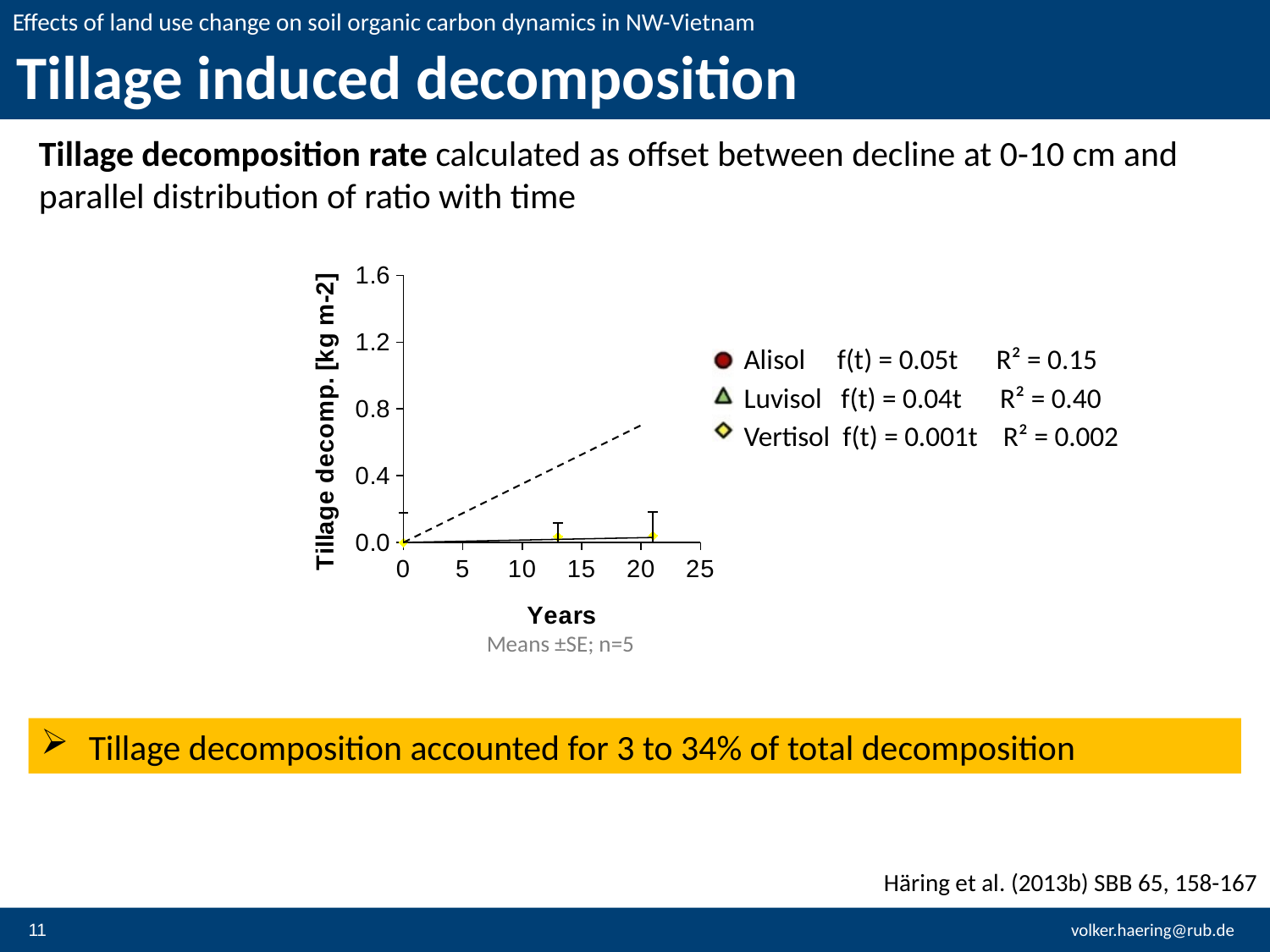
What is the label of the x axis of the chart? Years Does the dashed line rise or fall as Years increase along the x axis? rise Is the plotted tillage decomposition value at around 20 years greater or less than 0.4 kg m-2? less What is the R² value given for Alisol in the legend? R² = 0.15 What is the fitted function given for Vertisol in the legend? f(t) = 0.001t Which series has the highest R² value according to the legend? Luvisol How many series does the chart legend list? 3 Which series has the lowest R² value according to the legend? Vertisol What kind of chart is shown on the slide? scatter chart with trend lines What is the R² value given for Luvisol in the legend? R² = 0.40 What is the maximum value shown on the y axis of the chart? 1.6 What is the label of the y axis of the chart? Tillage decomp. [kg m-2]